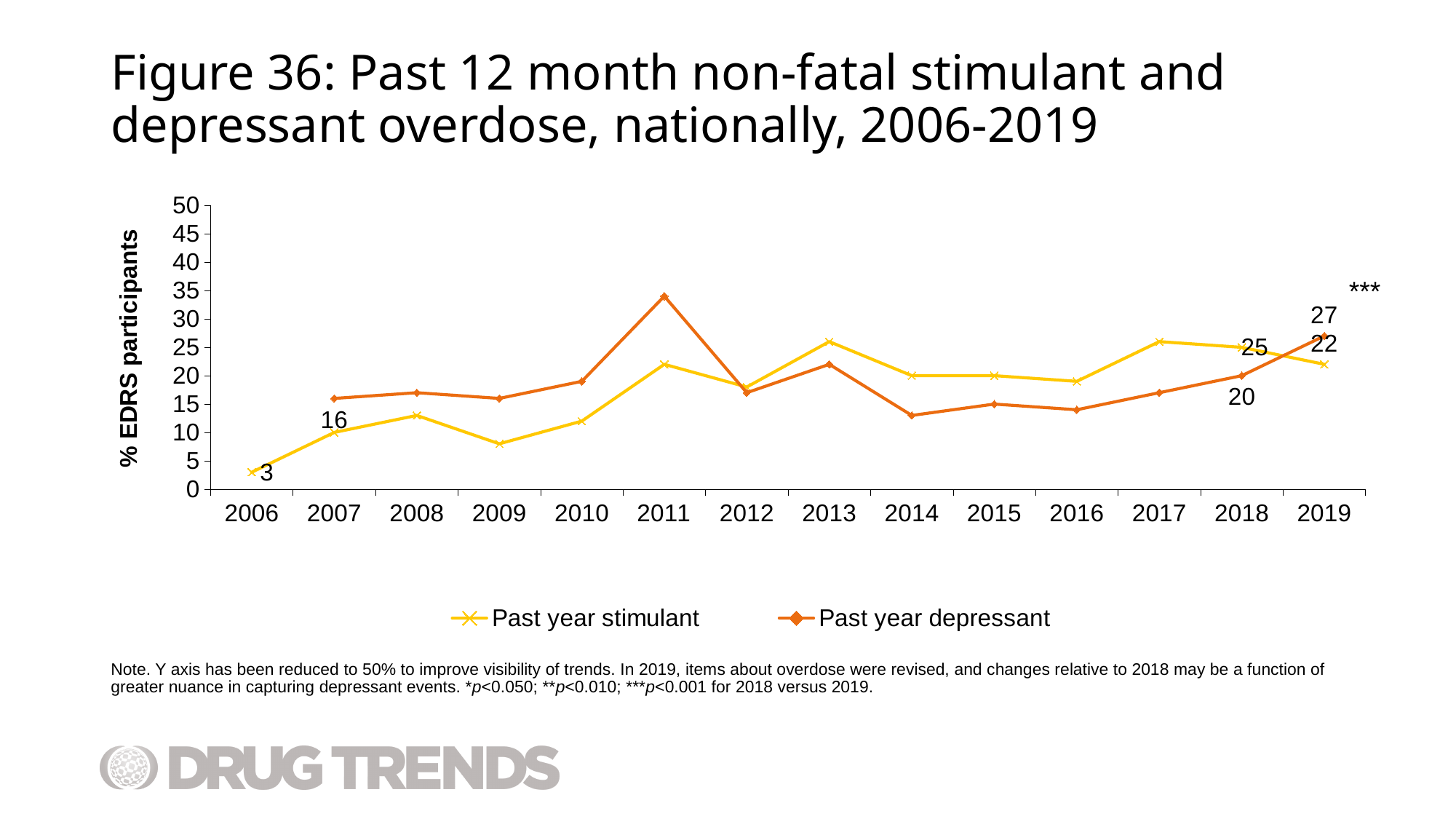
What is the value for Past year stimulant in 2018? 25 How many years are shown on the x axis? 14 How many series does the legend list? 2 What is the value for Past year stimulant in 2019? 22 What type of chart is shown on the slide? line chart What is the value for Past year depressant in 2018? 20 In which year does Past year depressant reach its highest value? 2011 By how much did Past year depressant increase from 2018 to 2019? 7 Is the value for Past year depressant in 2011 greater or less than 30? greater What is the value for Past year depressant in 2019? 27 In 2019, which series has the higher value, Past year stimulant or Past year depressant? Past year depressant What is the value for Past year stimulant in 2006? 3